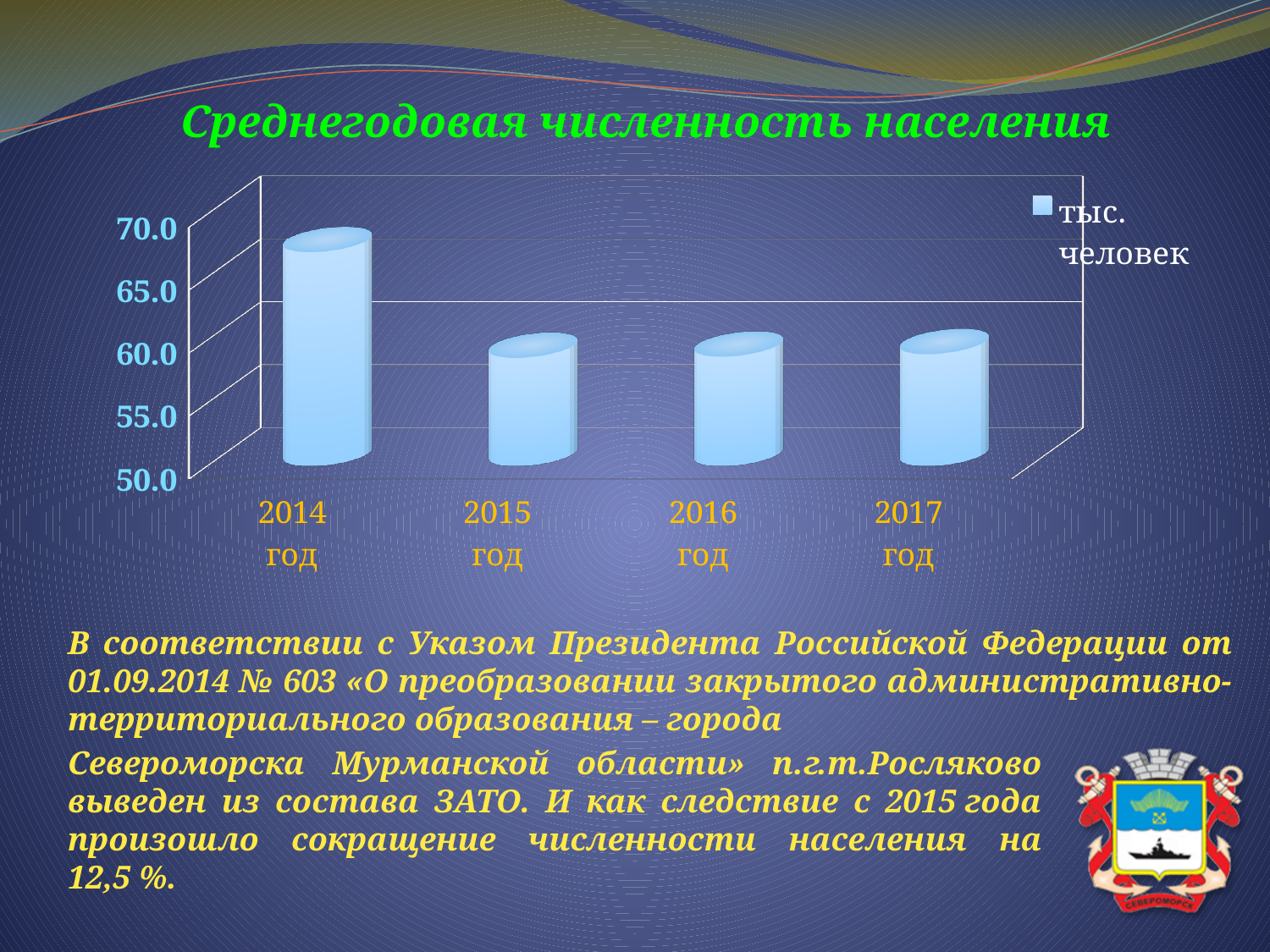
Which year has the highest value? 2014 год Is the value for 2017 год greater or less than 65.0? less Is the value for 2015 год greater or less than 65.0? less What is the title of the chart? Среднегодовая численность населения Is the value for 2016 год greater or less than 55.0? greater What is the legend entry of the chart? тыс. человек What kind of chart is shown on the slide? bar chart Which is larger, the value for 2014 год or the value for 2015 год? 2014 год How many categories (years) are shown on the x axis? 4 How many series does the legend list? 1 Does the value rise or fall from 2014 год to 2015 год? fall